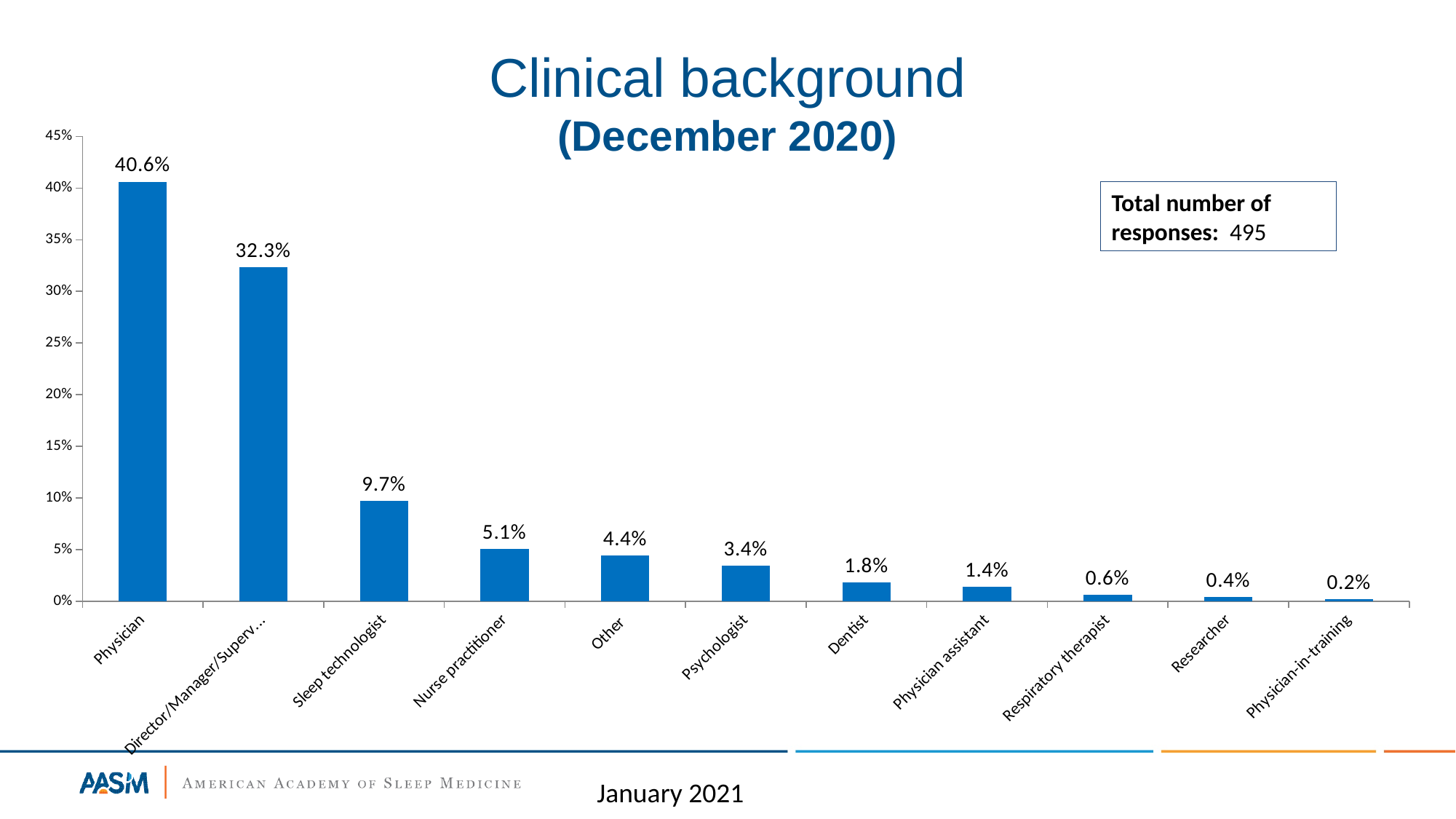
Which clinical background has the lowest percentage? Physician-in-training Is the value for Physician greater or less than 40%? greater What kind of chart is shown on the slide? Bar chart Which clinical background has the highest percentage? Physician How many clinical background categories are shown on the chart? 11 Do the values rise or fall from left to right along the x axis? Fall What is the value for Sleep technologist? 9.7% What is the total number of responses stated on the slide? 495 What percentage of respondents are Physicians? 40.6% Which is larger, the value for Nurse practitioner or the value for Psychologist? Nurse practitioner What percentage is shown for Dentist? 1.8% What is the difference between the Physician and Sleep technologist percentages? 30.9%